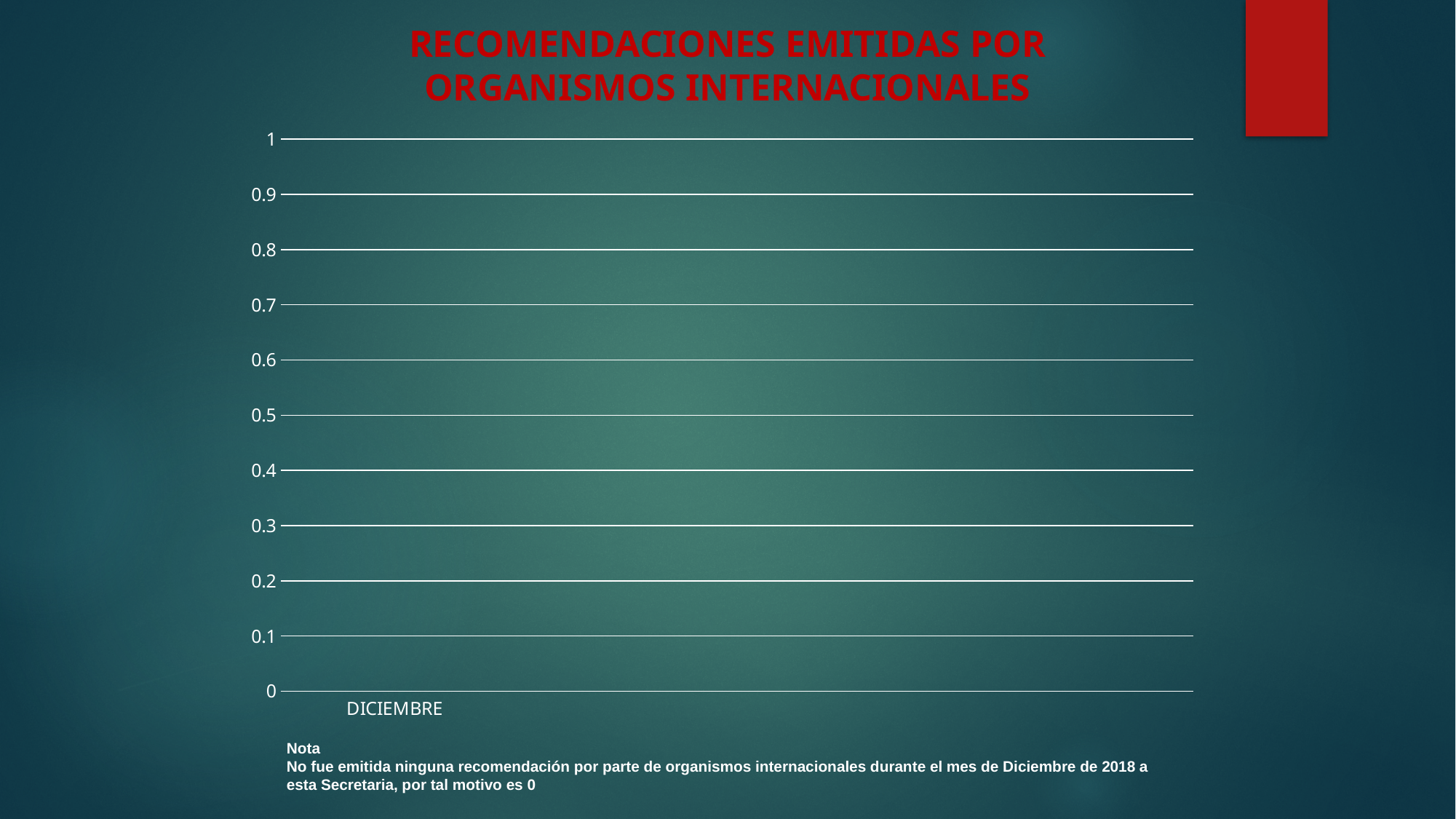
Is the value for DICIEMBRE greater or less than 0.5? less What is the highest value shown on the y axis of the chart? 1 Which category is shown on the x axis of the chart? DICIEMBRE How many categories are shown on the x axis of the chart? 1 What is the lowest value shown on the y axis of the chart? 0 According to the note, how many recommendations were issued by international organisations in December 2018? 0 What is the title of the chart? RECOMENDACIONES EMITIDAS POR ORGANISMOS INTERNACIONALES What is the value for DICIEMBRE in the chart? 0